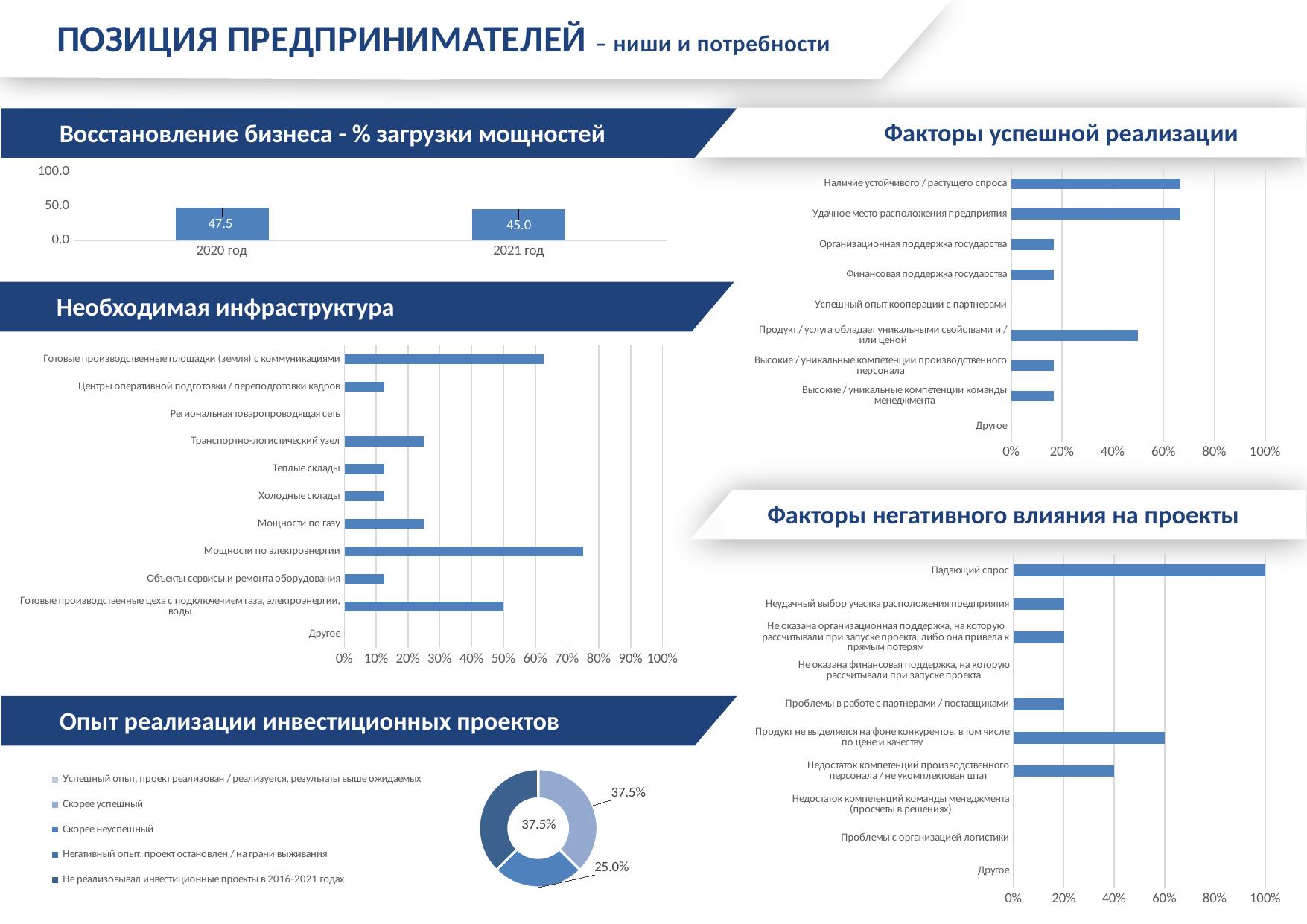
In the chart 'Факторы негативного влияния на проекты', which category has the highest value? Падающий спрос How many entries does the legend of the chart 'Опыт реализации инвестиционных проектов' list? 5 In the chart 'Восстановление бизнеса - % загрузки мощностей', what is the value for 2021 год? 45.0 What kind of chart is shown under 'Опыт реализации инвестиционных проектов'? doughnut chart In the chart 'Восстановление бизнеса - % загрузки мощностей', do the values rise or fall from 2020 год to 2021 год? fall In the chart 'Факторы успешной реализации', is the value for 'Продукт / услуга обладает уникальными свойствами и / или ценой' greater or less than 'Организационная поддержка государства'? greater In the chart 'Необходимая инфраструктура', how many categories are listed on the vertical axis? 11 In the chart 'Необходимая инфраструктура', is the value for 'Готовые производственные площадки (земля) с коммуникациями' greater or less than 50%? greater In the chart 'Восстановление бизнеса - % загрузки мощностей', what is the difference between the 2020 год and 2021 год values? 2.5 In the chart 'Факторы негативного влияния на проекты', is the value for 'Недостаток компетенций производственного персонала / не укомплектован штат' greater or less than 20%? greater In the chart 'Необходимая инфраструктура', which category has the highest value? Мощности по электроэнергии In the chart 'Восстановление бизнеса - % загрузки мощностей', what is the value for 2020 год? 47.5